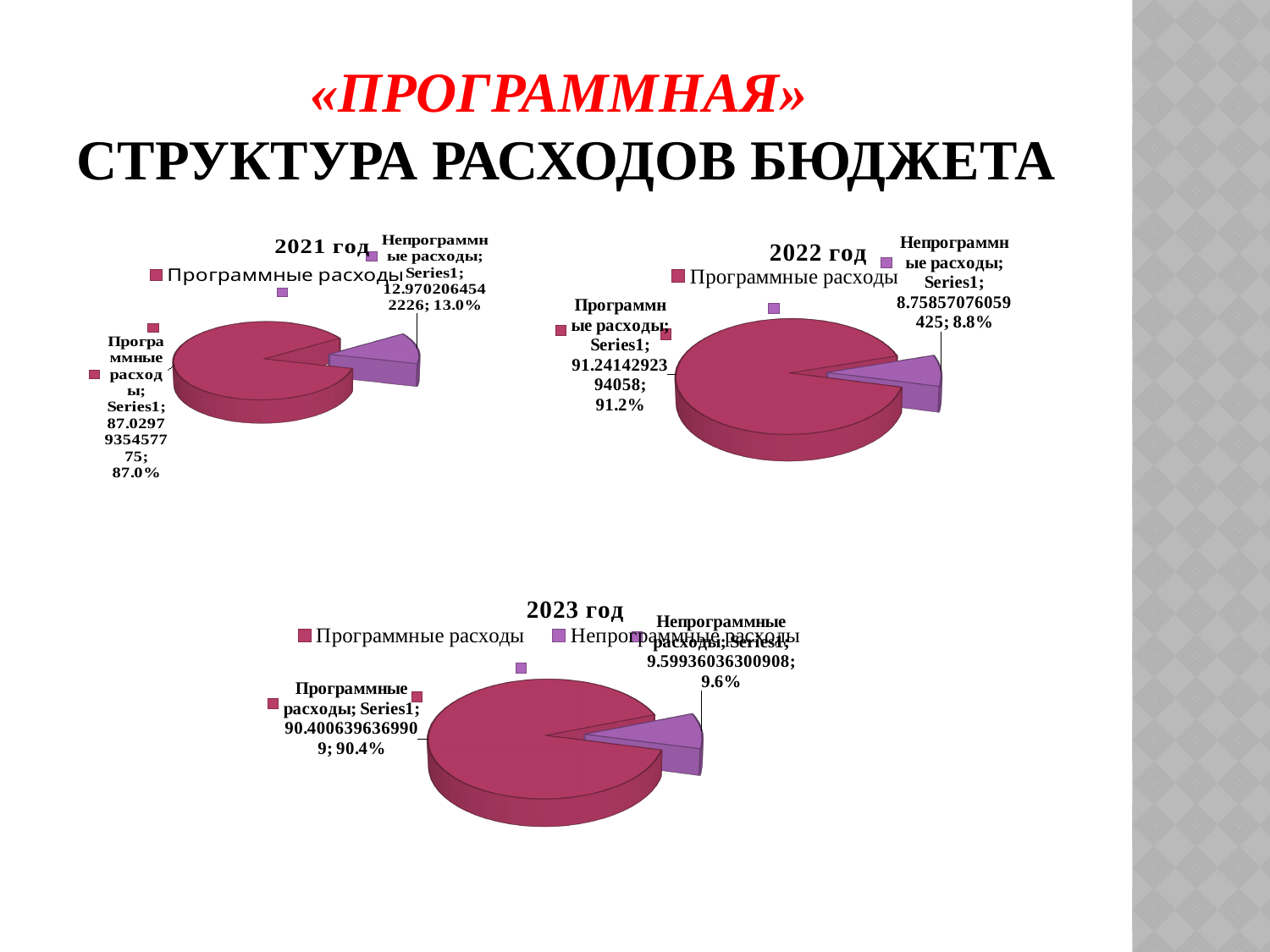
On the chart titled "2022 год", what percentage is shown for Программные расходы? 91.2% On the chart titled "2021 год", what percentage is shown for Непрограммные расходы? 13.0% What kind of chart is the chart titled "2023 год"? Pie chart On the chart titled "2021 год", which slice is the largest? Программные расходы On the chart titled "2023 год", what percentage is shown for Программные расходы? 90.4% On the chart titled "2022 год", what percentage is shown for Непрограммные расходы? 8.8% On the chart titled "2022 год", which slice is the smallest? Непрограммные расходы How many charts are shown on the slide? 3 On the chart titled "2021 год", what is the difference in percentage points between Программные расходы and Непрограммные расходы? 74.0 How many slices does the chart titled "2022 год" have? 2 On the chart titled "2023 год", what percentage is shown for Непрограммные расходы? 9.6% On the chart titled "2021 год", what percentage is shown for Программные расходы? 87.0%